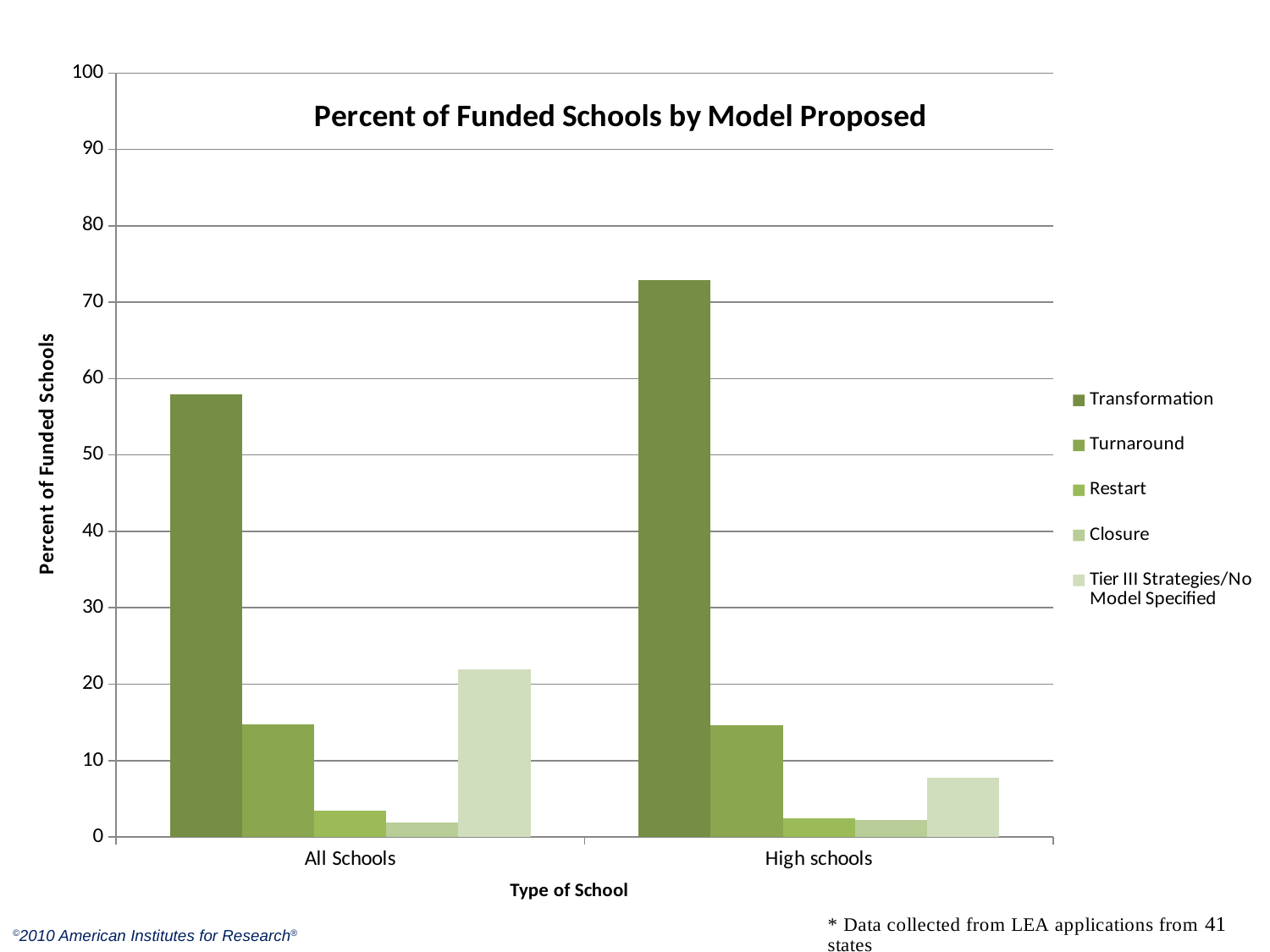
What is the title of the chart? Percent of Funded Schools by Model Proposed Is the Tier III Strategies/No Model Specified value for High schools greater or less than 10? less Which model has the lowest percentage for All Schools? Closure Which model has the highest percentage for All Schools? Transformation Is the Transformation value for All Schools greater or less than 50? greater Which model has the highest percentage for High schools? Transformation Is the Transformation percentage larger for All Schools or for High schools? High schools How many school-type categories are shown on the x axis? 2 What type of chart is shown on the slide? bar chart Is the Transformation value for High schools greater or less than 60? greater Is the Tier III Strategies/No Model Specified percentage larger for All Schools or for High schools? All Schools How many series does the legend list? 5